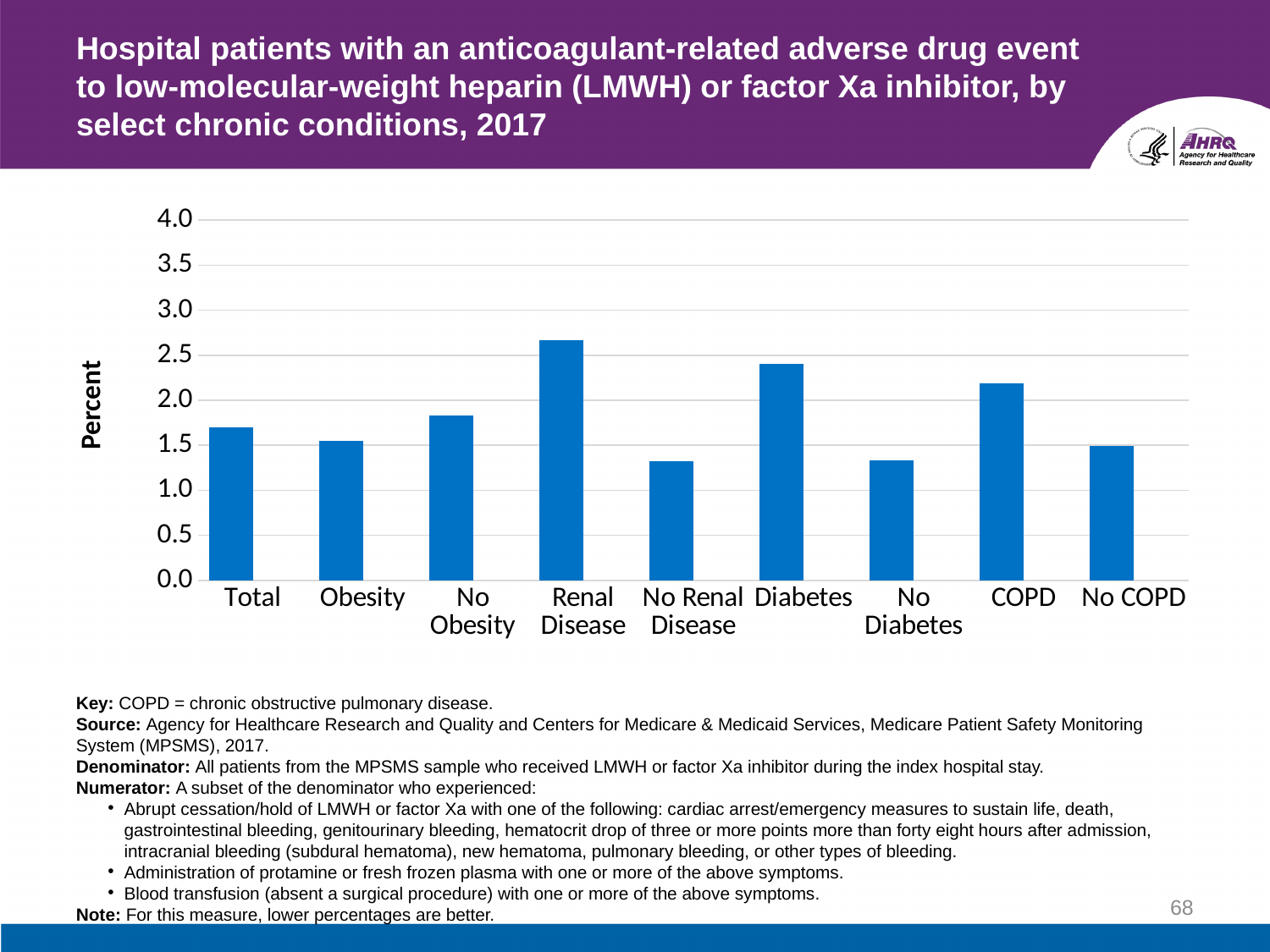
How many categories are shown on the x axis of the chart? 9 Is the value for Diabetes greater or less than 2.0? greater What is the maximum value shown on the y axis of the chart? 4.0 Which is larger, the value for Diabetes or the value for No Diabetes? Diabetes Is the value for Renal Disease greater or less than 2.5? greater Which is larger, the value for Obesity or the value for No Obesity? No Obesity Which category has the highest percentage in the chart? Renal Disease Is the value for No Renal Disease greater or less than 1.5? less What kind of chart is shown on the slide? bar chart What is the label on the y axis of the chart? Percent